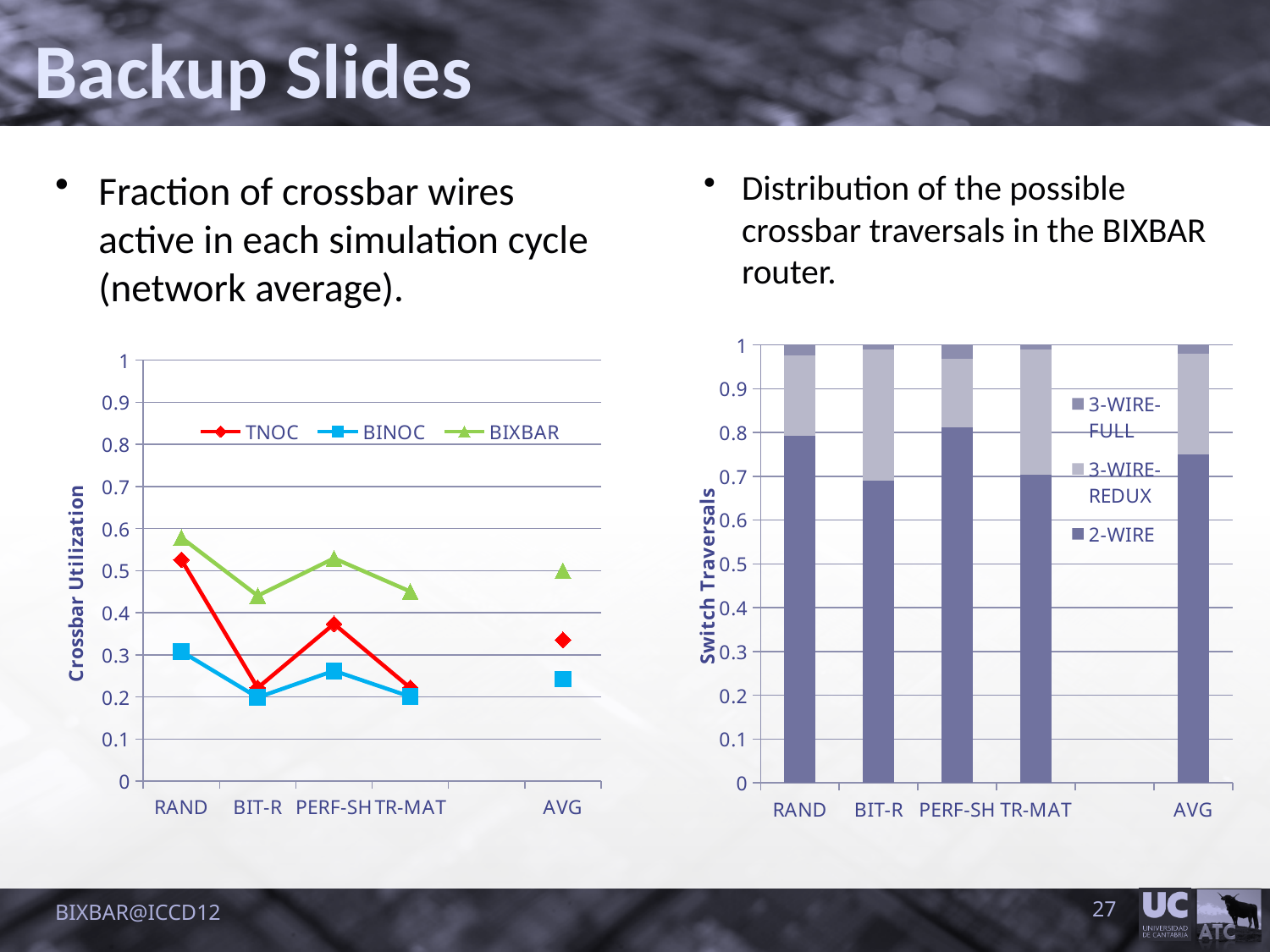
In the left chart (Crossbar Utilization), which series has the highest value at RAND? BIXBAR In the left chart (Crossbar Utilization), is the TNOC value for BIT-R greater or less than 0.3? less In the left chart (Crossbar Utilization), at which category does BIXBAR reach its highest value? RAND In the left chart (Crossbar Utilization), how many categories are shown on the x axis? 5 In the right chart (Switch Traversals), how many series does the legend list? 3 What kind of chart is the right chart (Switch Traversals)? bar chart In the left chart (Crossbar Utilization), how many series does the legend list? 3 What kind of chart is the left chart (Crossbar Utilization)? line chart In the left chart (Crossbar Utilization), which is larger at PERF-SH, TNOC or BINOC? TNOC In the left chart (Crossbar Utilization), does the TNOC value rise or fall from RAND to BIT-R? fall In the right chart (Switch Traversals), is the 2-WIRE value for RAND greater or less than 0.7? greater In the left chart (Crossbar Utilization), is the BIXBAR value for RAND greater or less than 0.5? greater